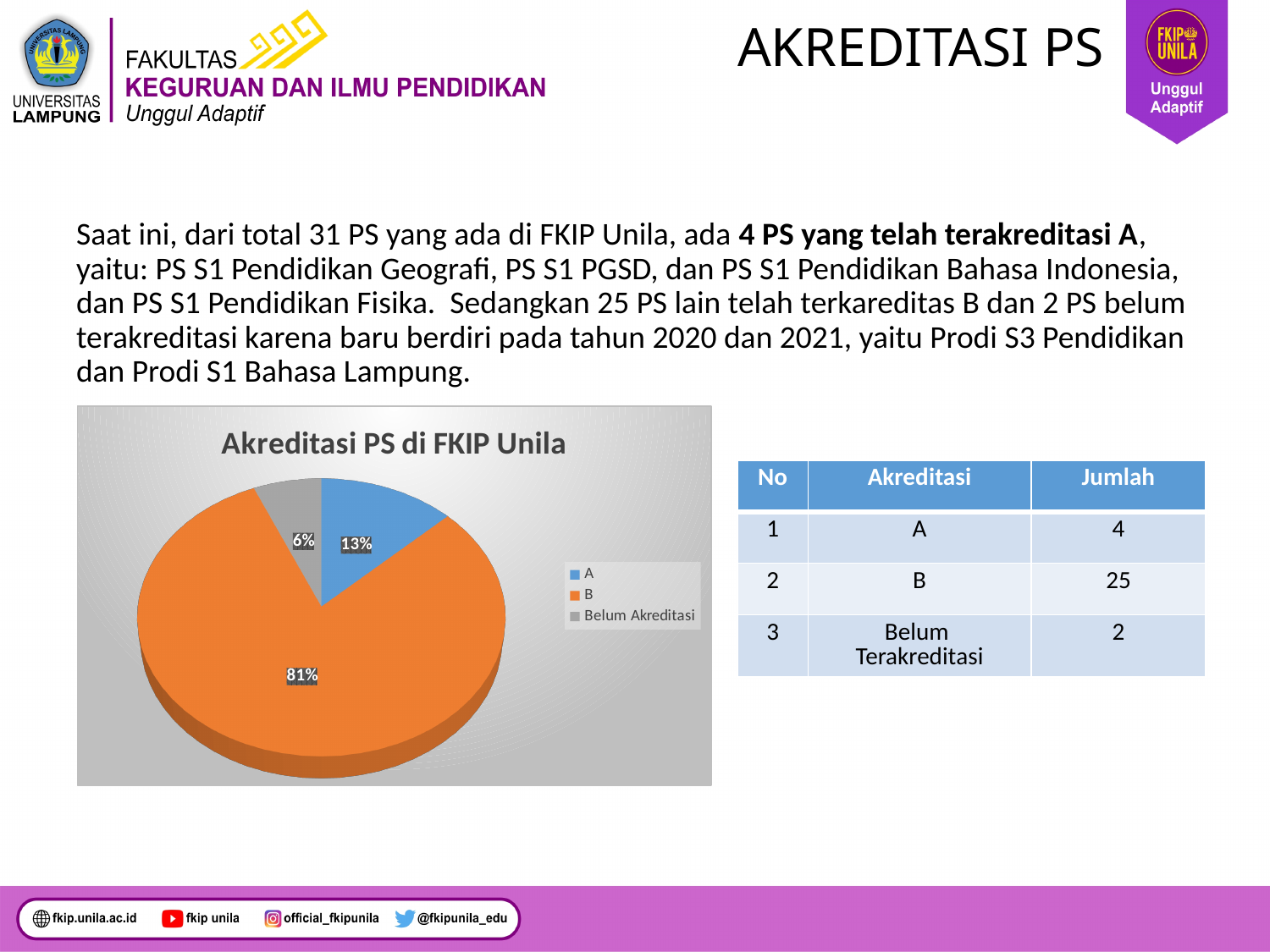
How many entries does the chart legend list? 3 What is the title of the chart? Akreditasi PS di FKIP Unila What share of the pie does the B slice represent? 81% Which category has the smallest slice of the pie? Belum Akreditasi What is the difference in percentage points between the B slice and the A slice? 68% Which slice is larger, A or Belum Akreditasi? A What share of the pie does the Belum Akreditasi slice represent? 6% Which category has the largest slice of the pie? B What share of the pie does the A slice represent? 13% What kind of chart is shown on the slide? pie chart How many slices does the pie chart have? 3 Which colour represents the B category in the pie chart? orange